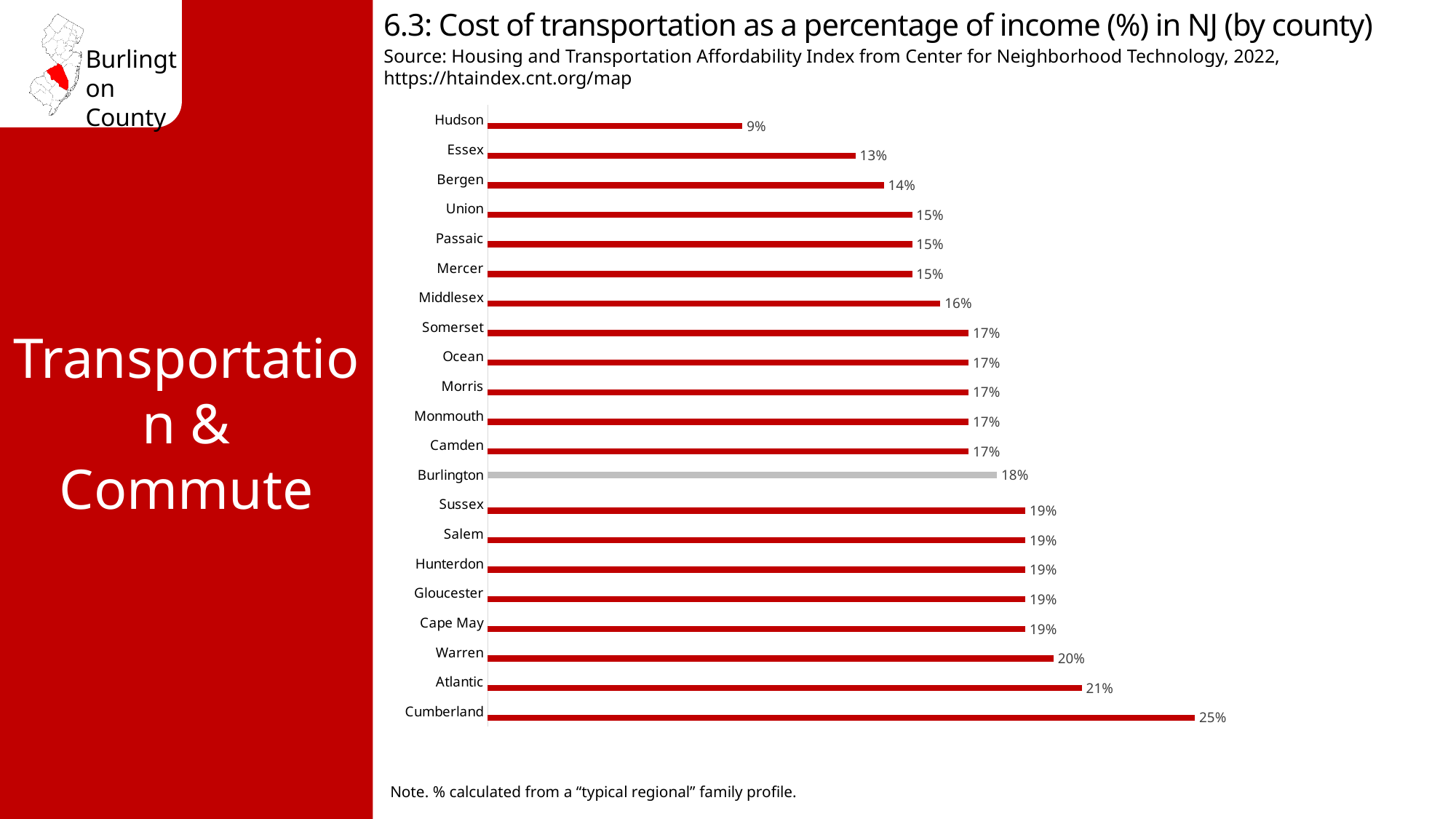
What is the cost of transportation as a percentage of income for Atlantic County? 21% Which county's bar is shown in grey rather than red? Burlington Which county has a higher transportation cost percentage, Warren or Middlesex? Warren What type of chart is used on this slide? Bar chart Which county has the highest cost of transportation as a percentage of income? Cumberland What is the cost of transportation as a percentage of income for Hudson County? 9% Which county has a higher transportation cost percentage, Bergen or Atlantic? Atlantic What is the difference between Cumberland's and Hudson's transportation cost percentages? 16% How many counties are shown in the chart? 21 Which county has the lowest cost of transportation as a percentage of income? Hudson What is the cost of transportation as a percentage of income for Burlington County? 18% What is the difference between Burlington's and Essex's transportation cost percentages? 5%